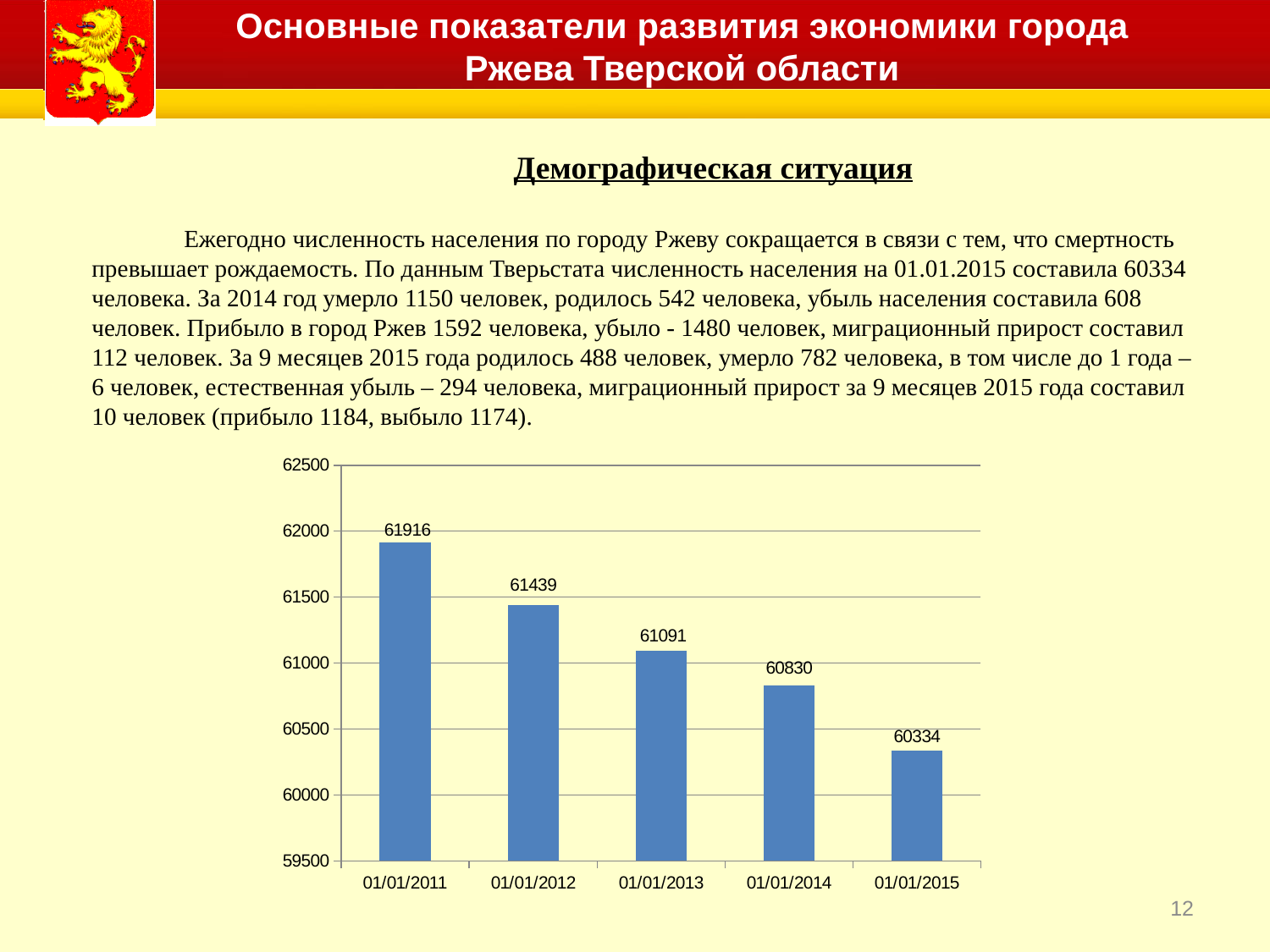
Which date has the highest value? 01/01/2011 What is the value shown for 01/01/2013? 61091 Do the values rise or fall from 01/01/2011 to 01/01/2015? fall Which is larger, the value for 01/01/2012 or the value for 01/01/2014? 01/01/2012 What is the difference between the values for 01/01/2011 and 01/01/2015? 1582 Is the value for 01/01/2014 greater or less than 61000? less What is the difference between the values for 01/01/2013 and 01/01/2014? 261 What is the value shown for 01/01/2011? 61916 What kind of chart is shown on the slide? bar chart How many bars are shown in the chart? 5 What is the value shown for 01/01/2015? 60334 Which date has the lowest value? 01/01/2015